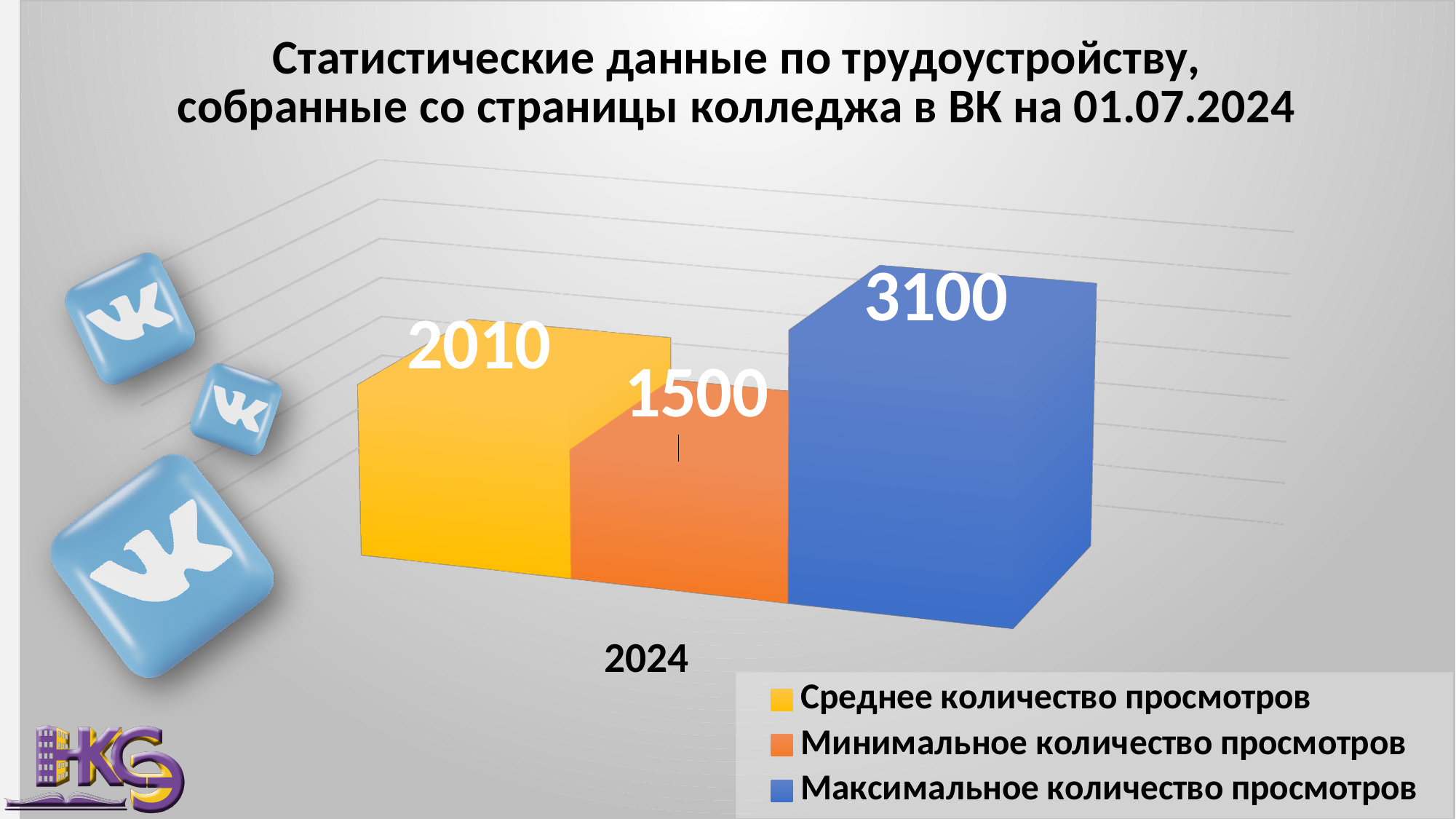
What category label is shown on the x axis? 2024 What is the difference between Среднее количество просмотров and Минимальное количество просмотров? 510 Which series has the highest value? Максимальное количество просмотров What is the value for Максимальное количество просмотров in 2024? 3100 How many series does the legend list? 3 What is the value for Минимальное количество просмотров in 2024? 1500 What is the value for Среднее количество просмотров in 2024? 2010 What is the difference between Максимальное количество просмотров and Минимальное количество просмотров? 1600 What colour is the bar for Максимальное количество просмотров? blue What kind of chart is shown on the slide? bar chart Which is larger, Среднее количество просмотров or Максимальное количество просмотров? Максимальное количество просмотров Which series has the lowest value? Минимальное количество просмотров